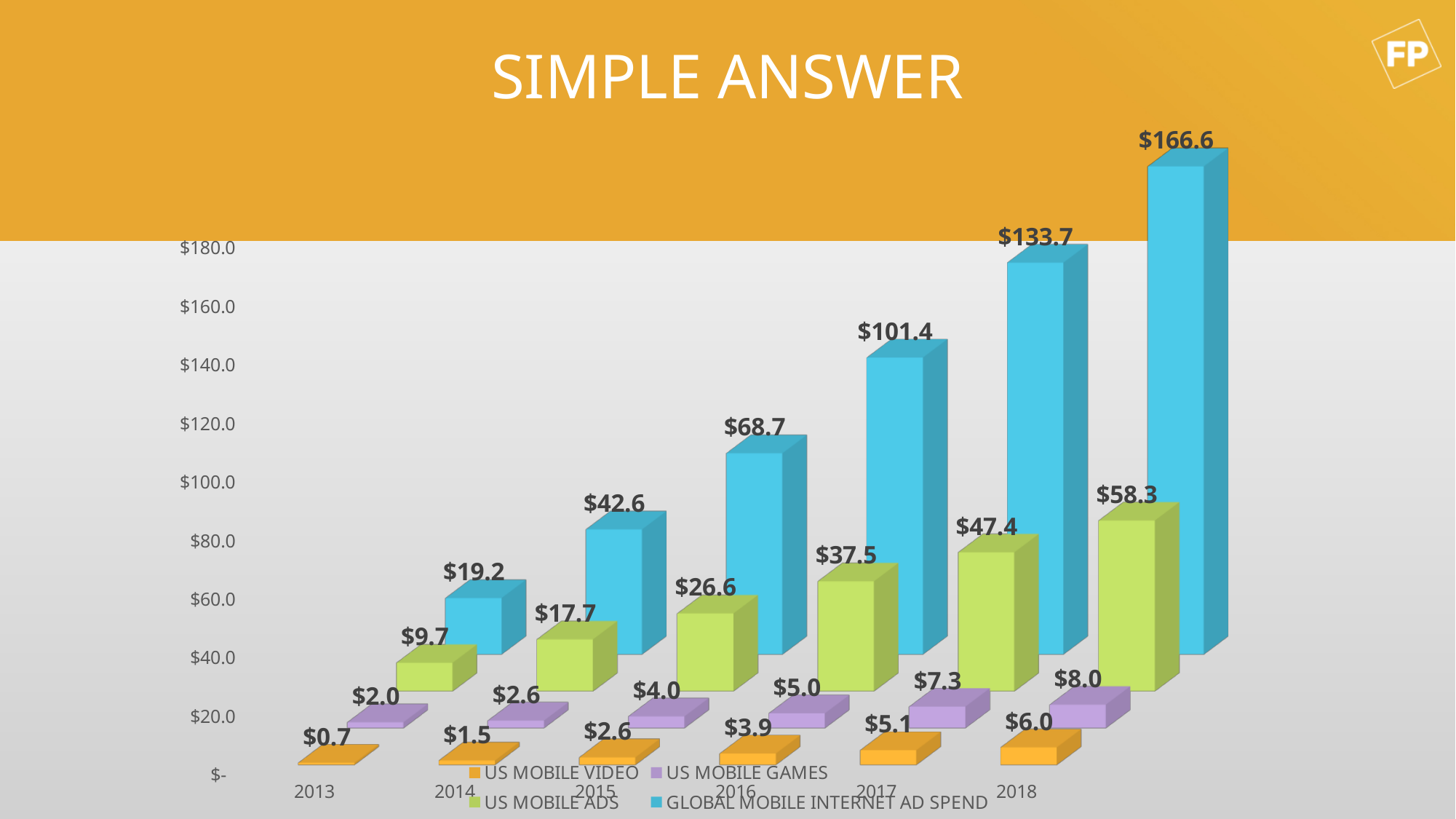
Which year has the highest value for Global Mobile Internet Ad Spend? 2018 Do the values for US Mobile Ads rise or fall from 2013 to 2018? Rise What is the difference between Global Mobile Internet Ad Spend in 2018 and 2017? $32.9 How many years are shown on the x axis? 6 What is the value for US Mobile Ads in 2016? $37.5 What is the value for US Mobile Games in 2017? $7.3 How many series does the legend list? 4 Which is larger in 2015: US Mobile Games or US Mobile Video? US Mobile Games What is the value for Global Mobile Internet Ad Spend in 2018? $166.6 What is the value for US Mobile Video in 2013? $0.7 Which year has the lowest value for US Mobile Ads? 2013 What kind of chart is shown on the slide? Bar chart